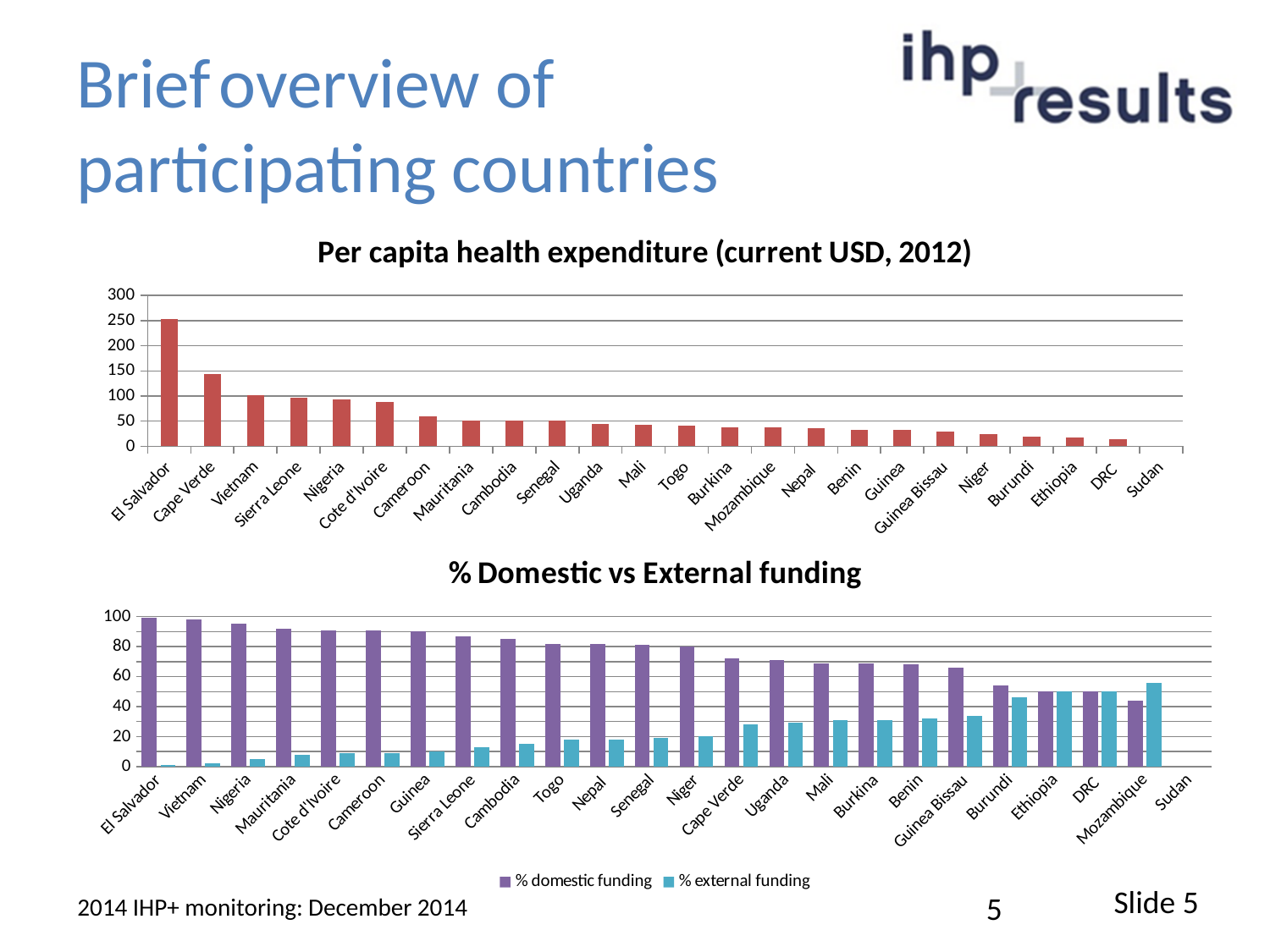
In the 'Per capita health expenditure (current USD, 2012)' chart, is the value for Cape Verde greater or less than 100? greater In the '% Domestic vs External funding' chart, is the % external funding for Vietnam greater or less than 20? less In the 'Per capita health expenditure (current USD, 2012)' chart, is the value for El Salvador greater or less than 200? greater In the 'Per capita health expenditure (current USD, 2012)' chart, do the values rise or fall from left to right along the x axis? fall In the '% Domestic vs External funding' chart, which is larger for Mozambique, % domestic funding or % external funding? % external funding In the 'Per capita health expenditure (current USD, 2012)' chart, which country has the highest value? El Salvador How many series does the legend of the '% Domestic vs External funding' chart list? 2 In the 'Per capita health expenditure (current USD, 2012)' chart, which is larger, the value for Nigeria or the value for Togo? Nigeria What kind of chart is the 'Per capita health expenditure (current USD, 2012)' chart? bar chart In the '% Domestic vs External funding' chart, what colour are the % external funding bars? blue